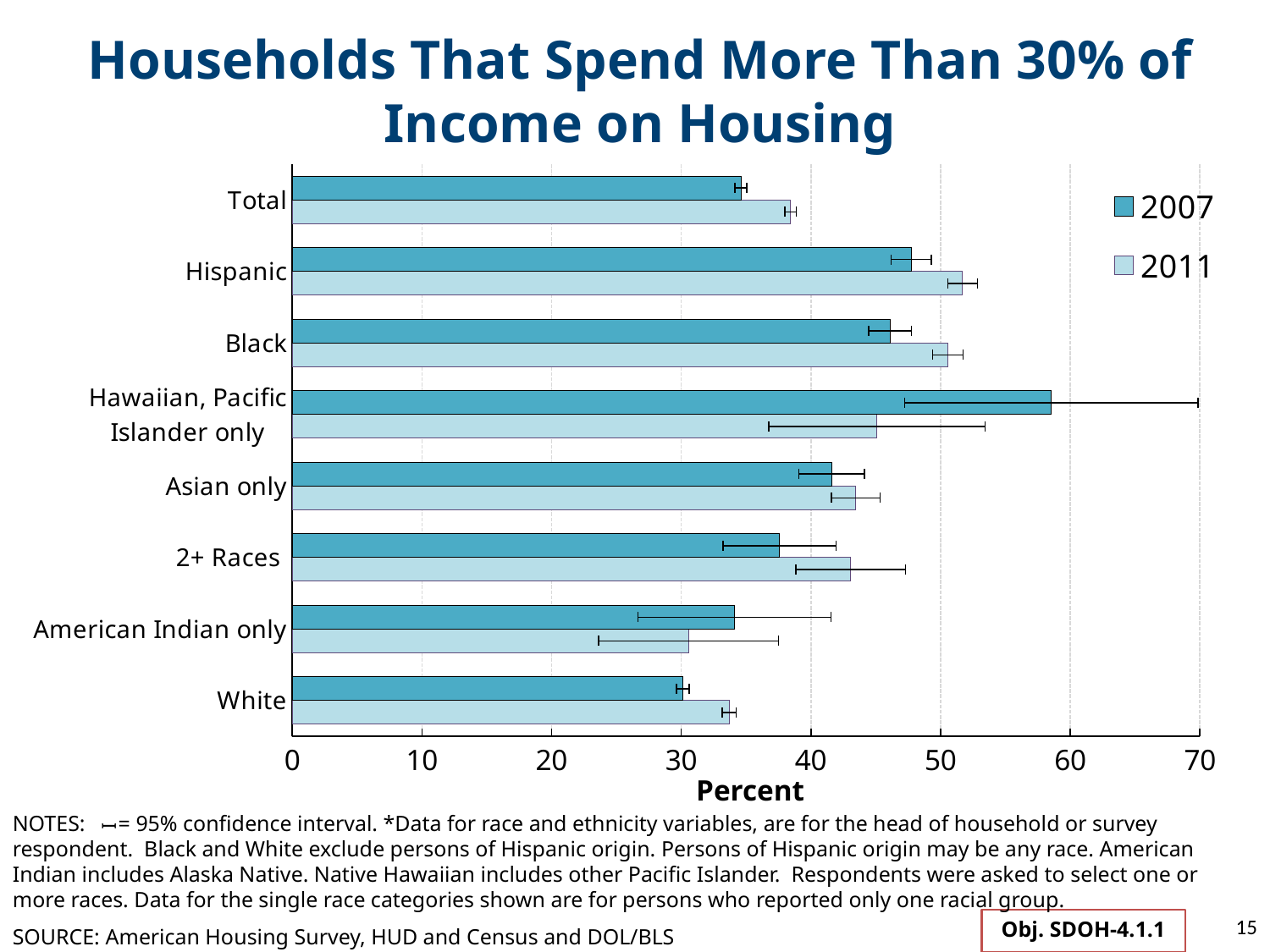
For Total, which year has the larger value, 2007 or 2011? 2011 Is the 2007 value for Hawaiian, Pacific Islander only greater or less than 50? greater How many series does the legend list? 2 Is the 2011 value for Hispanic greater or less than 50? greater What type of chart is shown on the slide? bar chart Is the 2011 value for White greater or less than 40? less Which category has the highest value for 2007? Hawaiian, Pacific Islander only How many categories are shown on the vertical axis of the chart? 8 What is the label of the horizontal axis? Percent For Hawaiian, Pacific Islander only, which year has the larger value, 2007 or 2011? 2007 Which category has the lowest value for 2007? White Which category has the lowest value for 2011? American Indian only